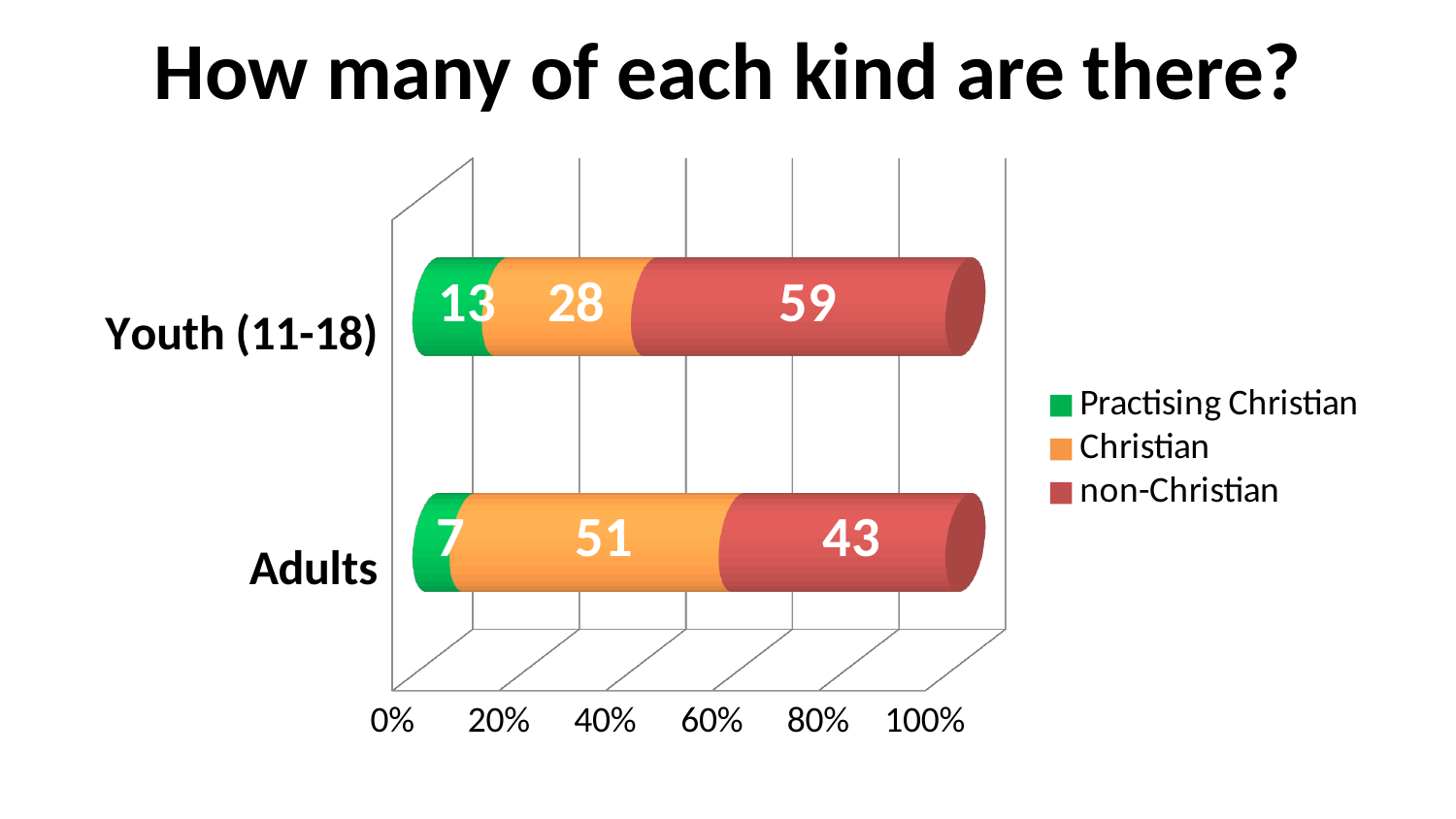
Which category has the higher non-Christian value, Youth (11-18) or Adults? Youth (11-18) What is the title of the chart? How many of each kind are there? What is the difference between the non-Christian values for Youth (11-18) and Adults? 16 What is the value for non-Christian in the Youth (11-18) bar? 59 How many categories are shown on the chart? 2 What kind of chart is shown on the slide? Stacked bar chart How many series does the legend list? 3 What is the difference between the Christian values for Adults and Youth (11-18)? 23 What is the value for Practising Christian in the Youth (11-18) bar? 13 What is the value for Christian in the Adults bar? 51 What is the total of the Youth (11-18) stacked bar? 100 What is the value for Practising Christian in the Adults bar? 7